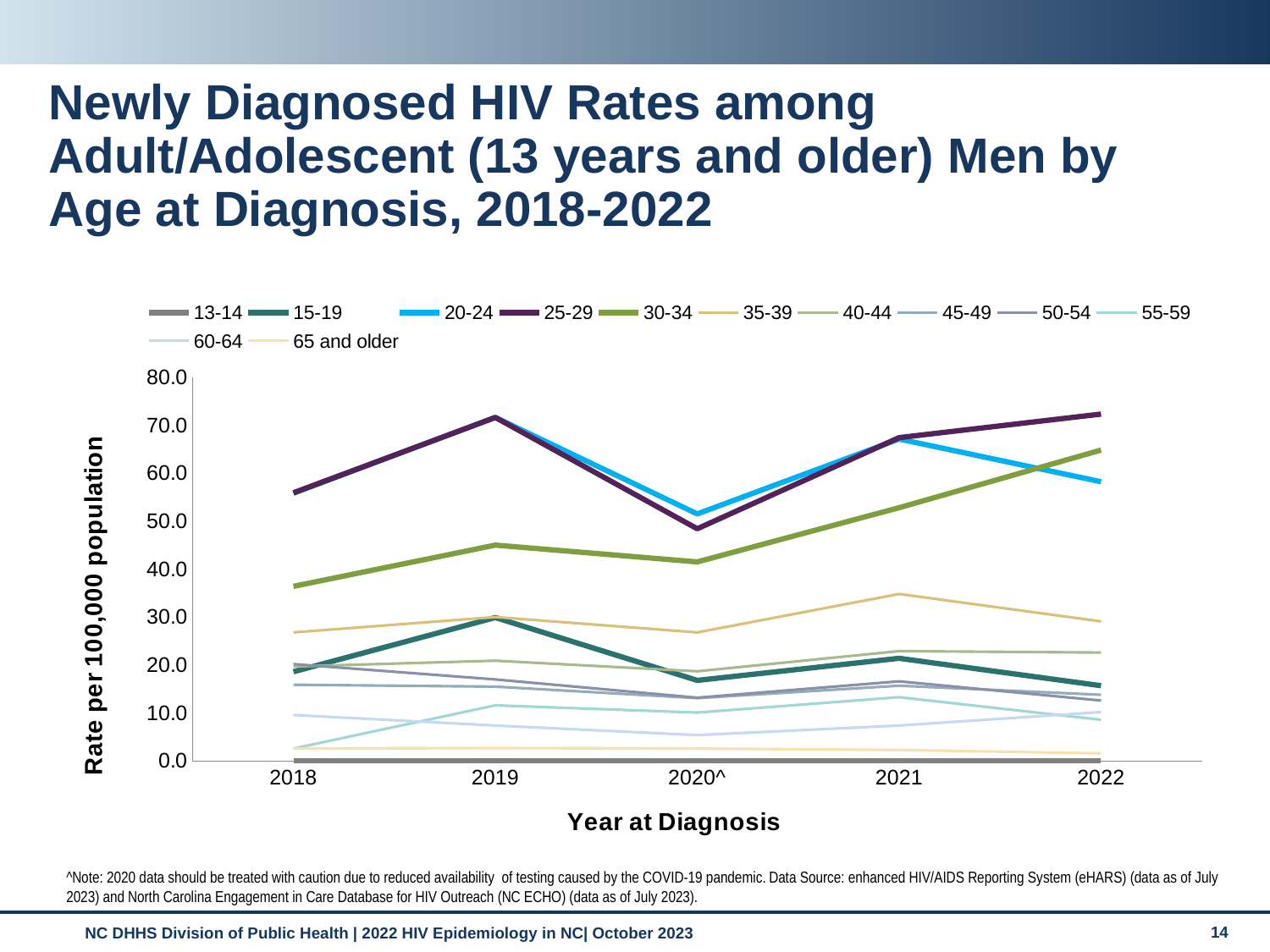
Which age group has the highest rate in 2022? 25-29 Is the rate for the 30-34 age group in 2018 greater or less than 40? less Is the rate for the 15-19 age group in 2022 greater or less than 20? less In 2021, which age group has the higher rate: 30-34 or 35-39? 30-34 Which age group has the lowest rate in 2022? 13-14 What is the title of the y axis? Rate per 100,000 population How many years are plotted along the x axis? 5 Is the rate for the 25-29 age group in 2018 greater or less than 50? greater Does the rate for the 30-34 age group rise or fall from 2020^ to 2022? rise How many age groups does the legend list? 12 What kind of chart is shown on the slide? line chart